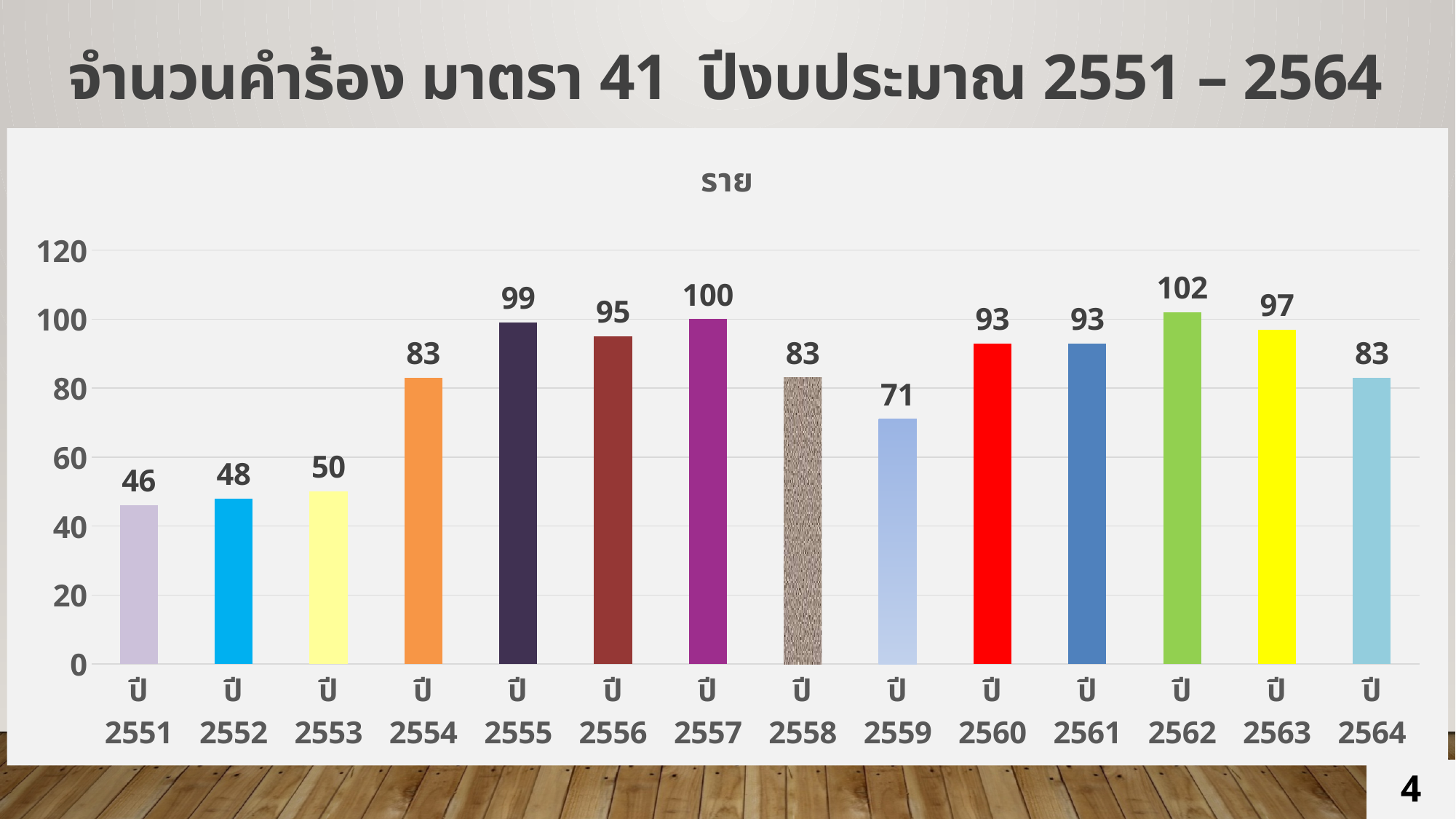
Which is larger, the value for ปี 2555 or the value for ปี 2556? ปี 2555 Which year has the lowest value? ปี 2551 How many years are shown on the x axis? 14 What is the value for ปี 2562? 102 Is the value for ปี 2563 greater or less than 80? greater Which year has the highest value? ปี 2562 What is the chart's title? ราย What is the value for ปี 2551? 46 What is the difference between the values for ปี 2557 and ปี 2558? 17 What kind of chart is this? bar chart What is the value for ปี 2559? 71 Do the values rise or fall from ปี 2551 to ปี 2555? rise